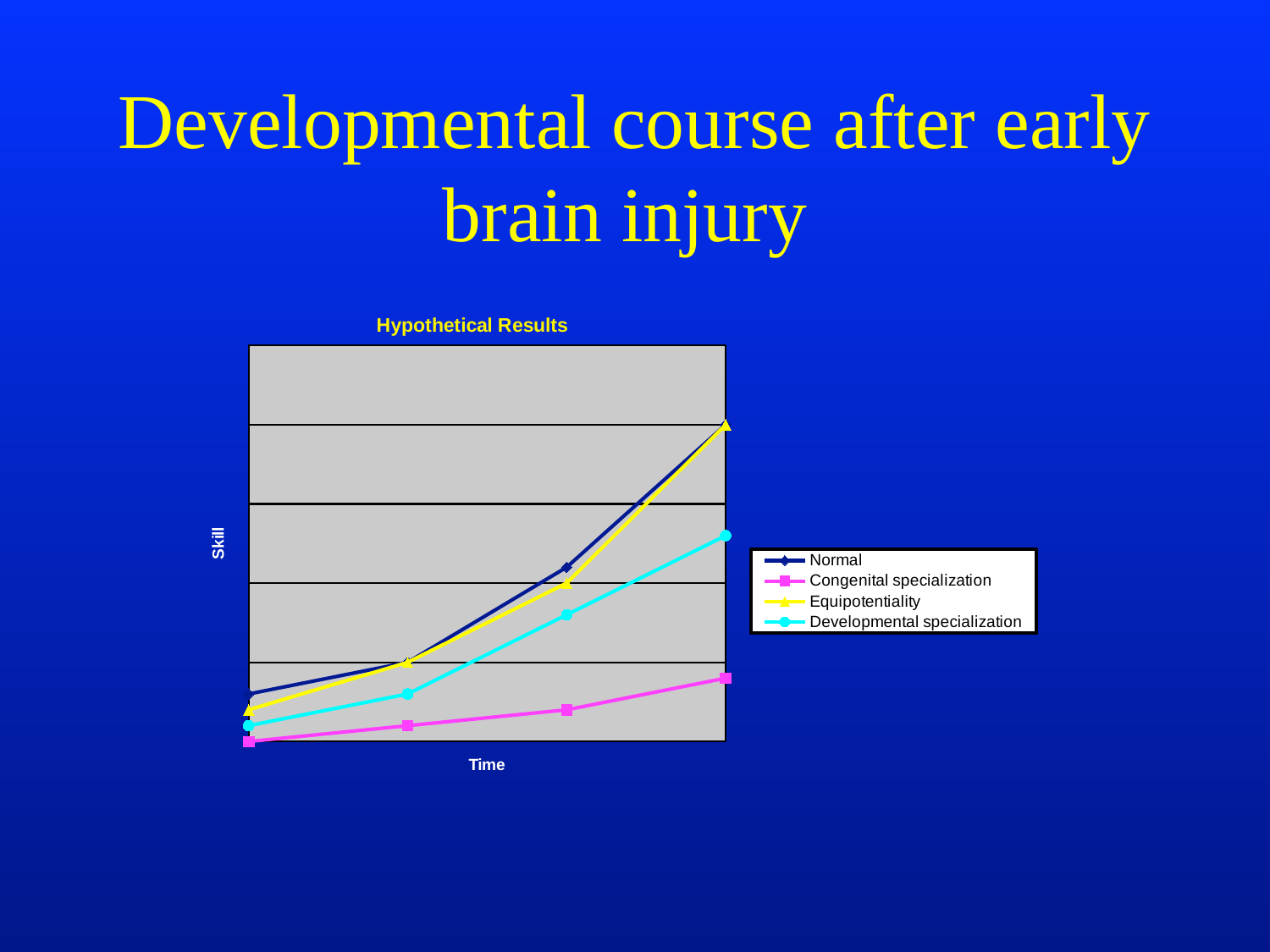
What is the label on the vertical axis of the chart? Skill Does the Normal series rise or fall along the Time axis? rise At the third time point, which is higher: Equipotentiality or Developmental specialization? Equipotentiality Does the Congenital specialization series rise or fall along the Time axis? rise How many series does the legend list? 4 At the final time point, which is higher: Normal or Developmental specialization? Normal What is the title of the chart? Hypothetical Results Which series is lowest at the first time point? Congenital specialization How many data points are plotted for the Normal series? 4 What kind of chart is shown on the slide? line chart Which series has the lowest Skill value at the final time point? Congenital specialization At the final time point, which is higher: Developmental specialization or Congenital specialization? Developmental specialization